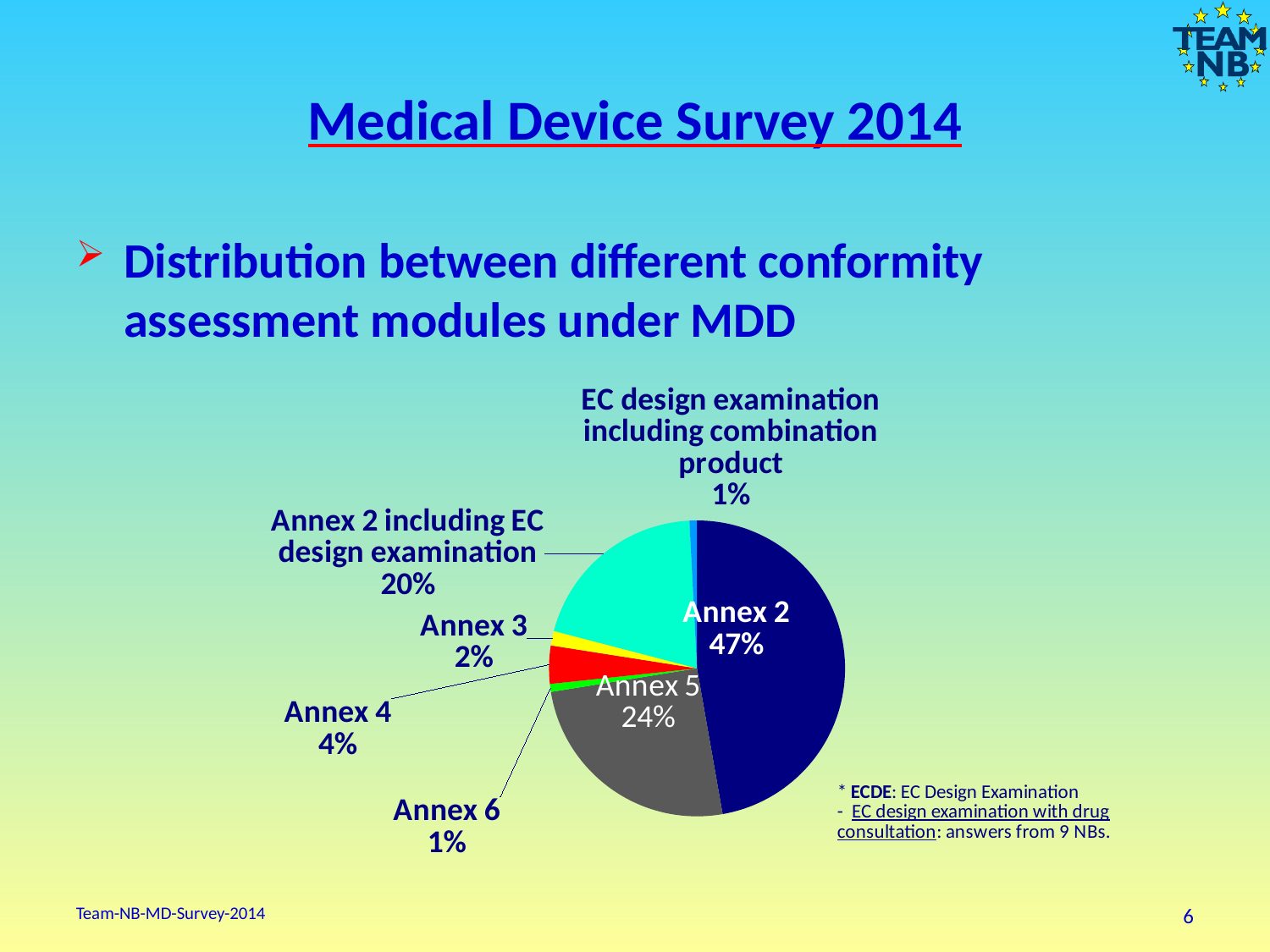
What kind of chart is shown on the slide? pie chart What is the value shown for Annex 4? 4% What is the value shown for EC design examination including combination product? 1% What is the value shown for Annex 2 including EC design examination? 20% How many slices does the pie chart have? 7 What is the value shown for Annex 3? 2% What colour is the Annex 5 slice? grey What share of the pie does Annex 2 represent? 47% What is the difference between the Annex 2 share and the Annex 5 share? 23% What is the value shown for Annex 5? 24% Which category has the largest slice of the pie? Annex 2 Which is larger, the share for Annex 4 or the share for Annex 3? Annex 4